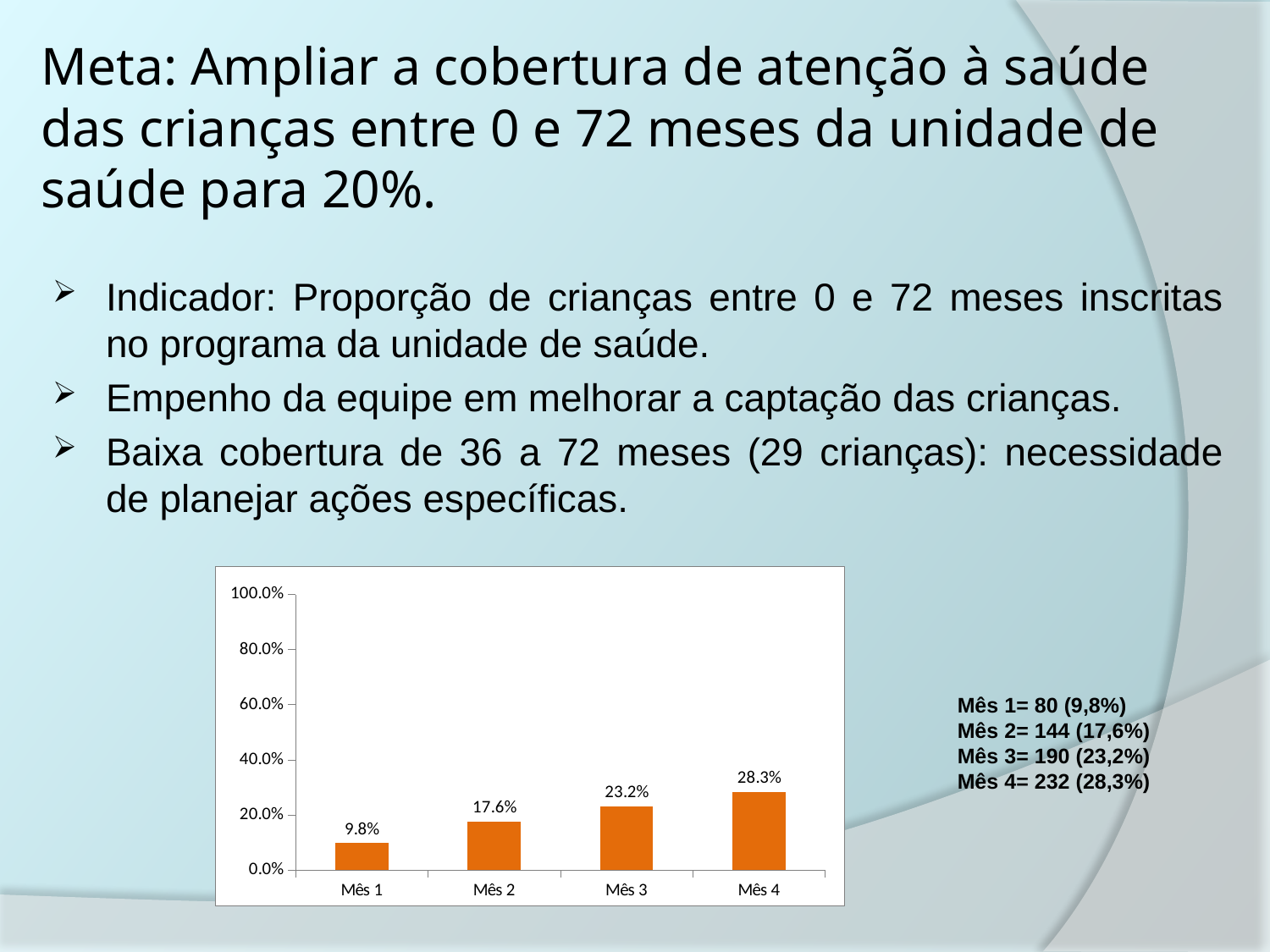
Which month has the lowest value? Mês 1 Which month has the highest value? Mês 4 Is the value for Mês 4 greater or less than 20.0%? greater What is the value for Mês 1? 9.8% What is the difference between the values for Mês 4 and Mês 1? 18.5% What is the value for Mês 3? 23.2% What is the value for Mês 4? 28.3% What kind of chart is shown on the slide? bar chart Which is larger, the value for Mês 2 or the value for Mês 3? Mês 3 Do the values rise or fall from Mês 1 to Mês 4? rise What is the difference between the values for Mês 2 and Mês 1? 7.8% How many months are shown on the x axis? 4